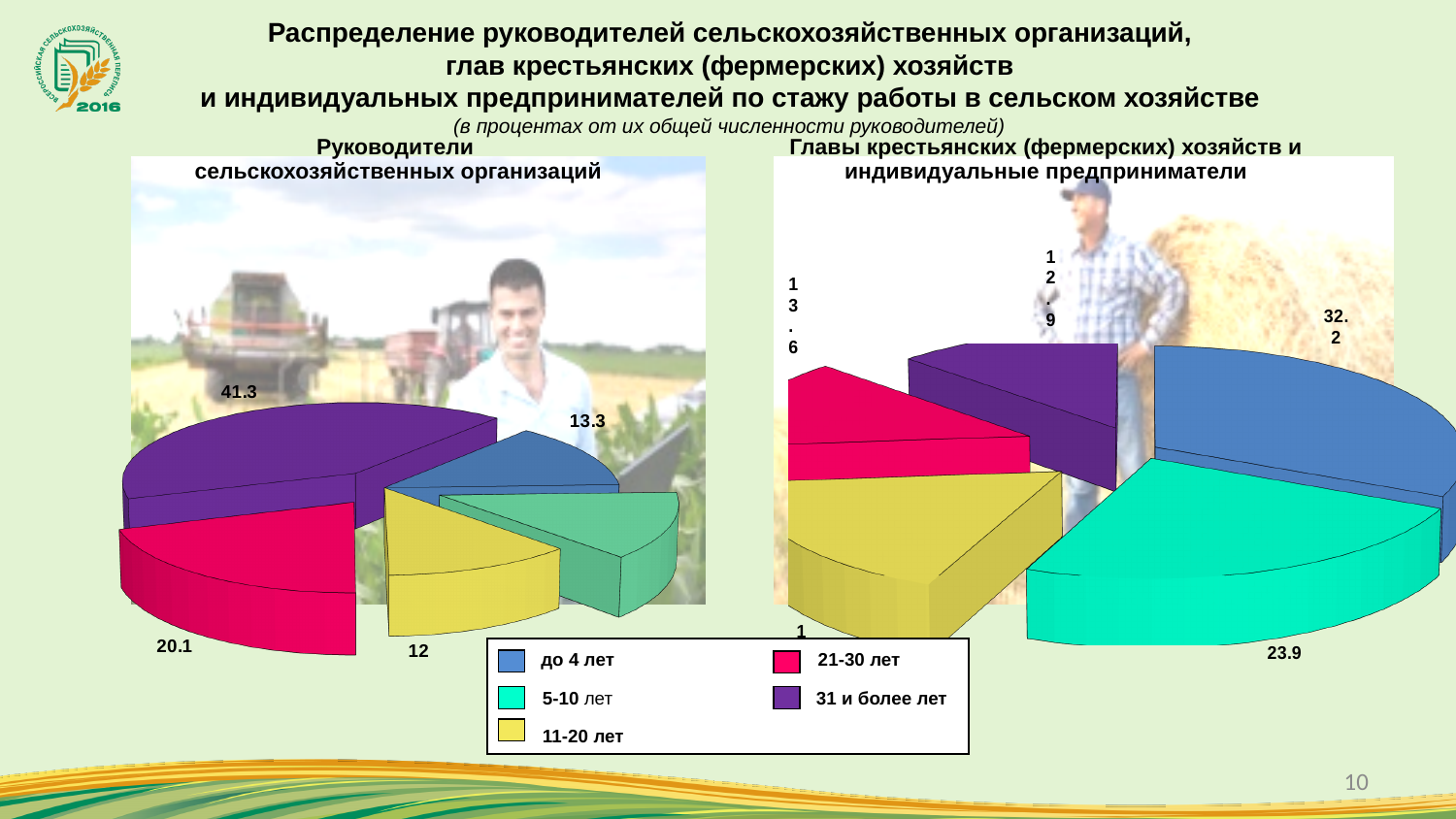
What kind of charts are shown on the slide? Pie charts In the chart 'Руководители сельскохозяйственных организаций', what is the difference between the values for '31 и более лет' and '21-30 лет'? 21.2 In the chart 'Руководители сельскохозяйственных организаций', which category has the largest share? 31 и более лет In the chart 'Главы крестьянских (фермерских) хозяйств и индивидуальные предприниматели', what is the value for '5-10 лет'? 23.9 How many categories of work experience does the legend list? 5 In the chart 'Главы крестьянских (фермерских) хозяйств и индивидуальные предприниматели', what is the value for 'до 4 лет'? 32.2 In the chart 'Главы крестьянских (фермерских) хозяйств и индивидуальные предприниматели', which category has the largest share? до 4 лет Which colour represents the category '11-20 лет' in the legend? Yellow In the chart 'Главы крестьянских (фермерских) хозяйств и индивидуальные предприниматели', what is the value for '21-30 лет'? 13.6 In the chart 'Руководители сельскохозяйственных организаций', what is the value for '31 и более лет'? 41.3 In the chart 'Руководители сельскохозяйственных организаций', what is the value for '21-30 лет'? 20.1 In the chart 'Руководители сельскохозяйственных организаций', what is the value for '11-20 лет'? 12